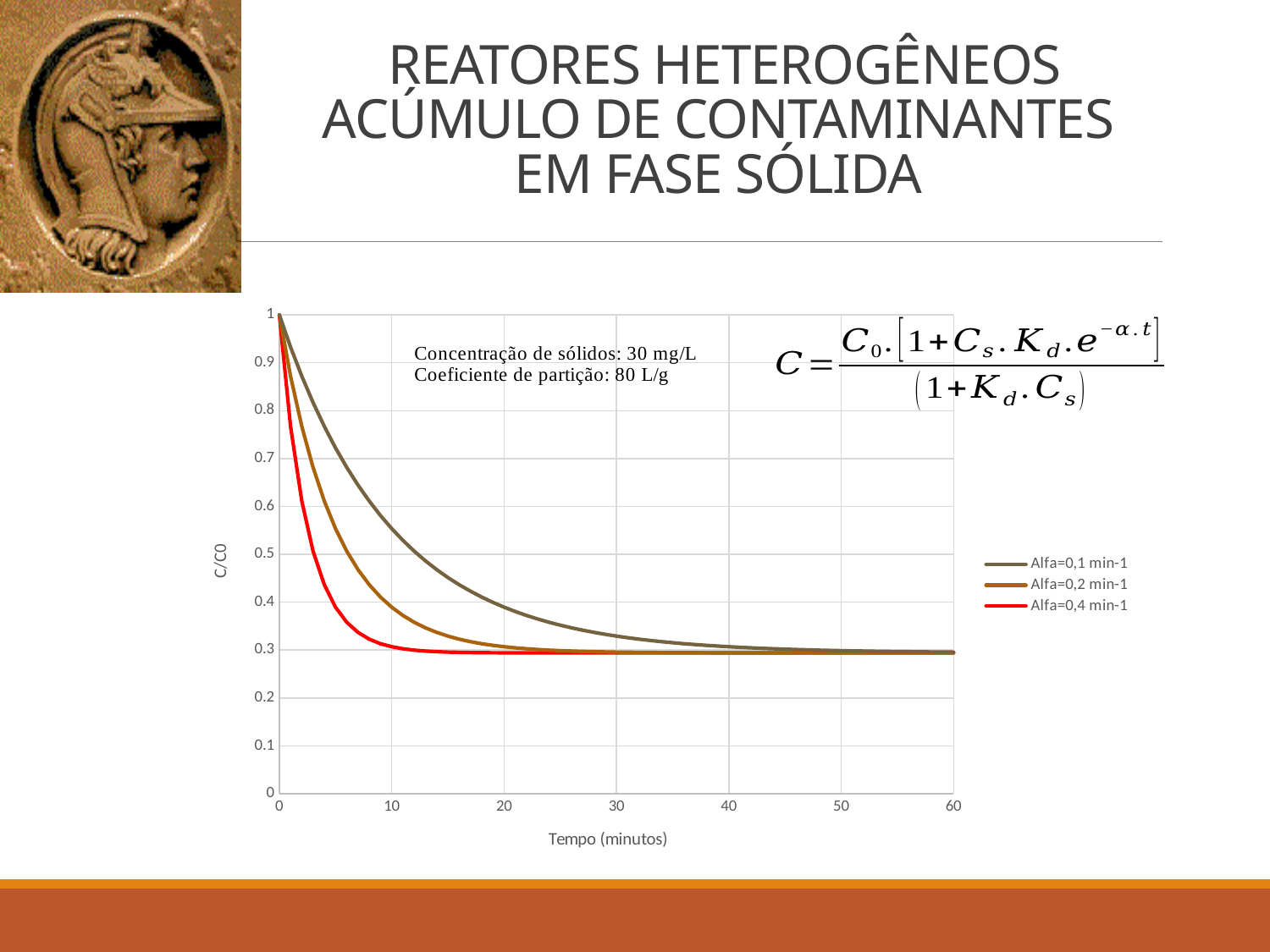
What is the title of the x axis? Tempo (minutos) Do the values of the Alfa=0,1 min-1 series rise or fall as time increases? fall How many series does the legend list? 3 At 10 minutes, which series has the highest C/C0 value? Alfa=0,1 min-1 What is the title of the y axis? C/C0 Is the value of the Alfa=0,4 min-1 series at 10 minutes greater or less than 0.4? less At 10 minutes, which series has the lowest C/C0 value? Alfa=0,4 min-1 What kind of chart is shown on the slide? line chart Is the value of the Alfa=0,1 min-1 series at 30 minutes greater or less than 0.4? less At 5 minutes, which is larger: the value for Alfa=0,2 min-1 or the value for Alfa=0,4 min-1? Alfa=0,2 min-1 What is the value of C/C0 for all three series at time 0? 1 Is the value of the Alfa=0,1 min-1 series at 10 minutes greater or less than 0.5? greater